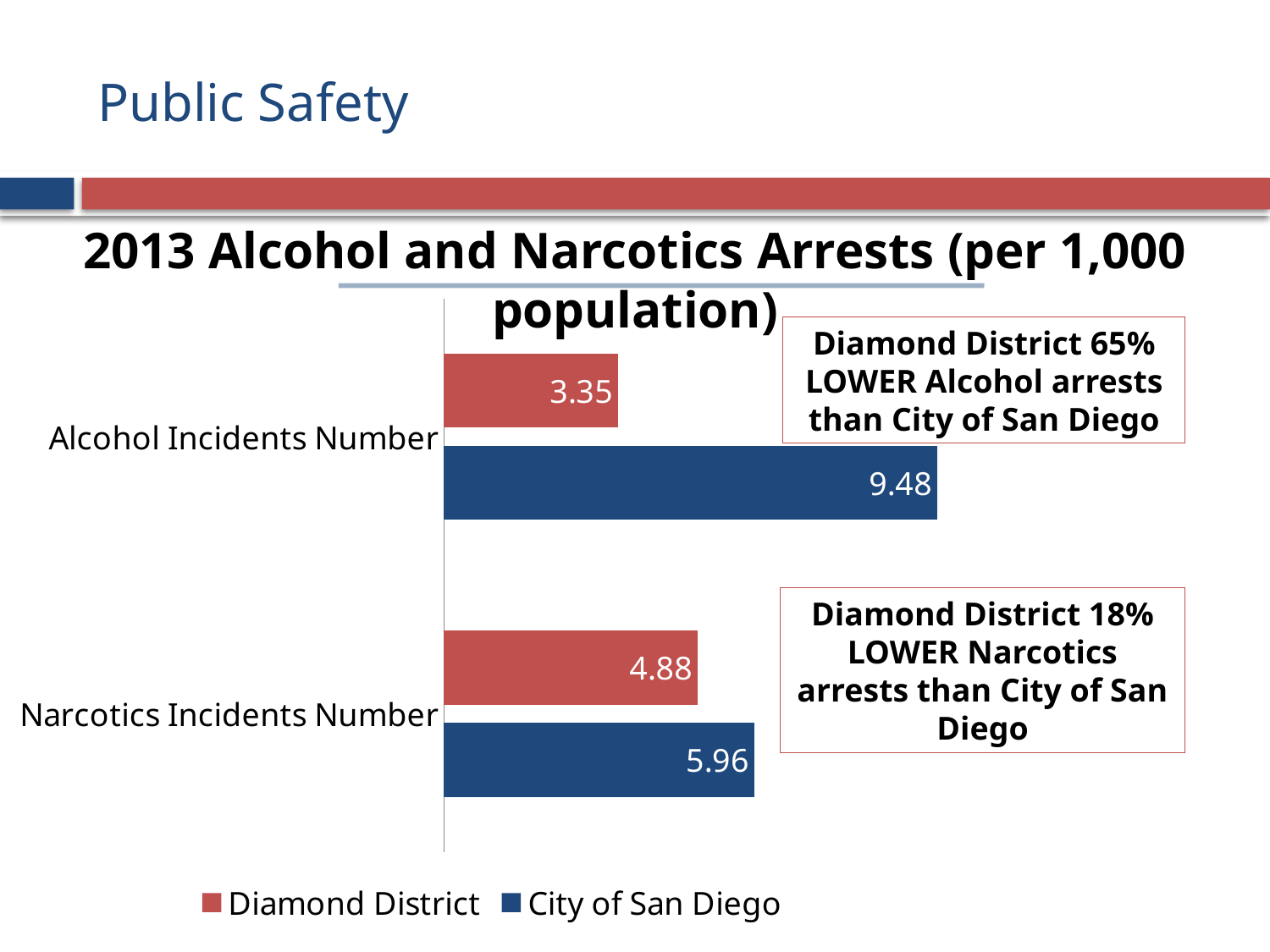
What is the value for Diamond District for Alcohol Incidents Number? 3.35 What is the difference between City of San Diego and Diamond District for Narcotics Incidents Number? 1.08 What is the value for Diamond District for Narcotics Incidents Number? 4.88 Which bar has the highest value on the chart? City of San Diego, Alcohol Incidents Number What is the value for City of San Diego for Narcotics Incidents Number? 5.96 How many categories are shown on the chart? 2 Which bar has the lowest value on the chart? Diamond District, Alcohol Incidents Number What kind of chart is shown on the slide? Bar chart What is the difference between City of San Diego and Diamond District for Alcohol Incidents Number? 6.13 Which is larger for Narcotics Incidents Number: Diamond District or City of San Diego? City of San Diego What is the value for City of San Diego for Alcohol Incidents Number? 9.48 How many series does the legend list? 2